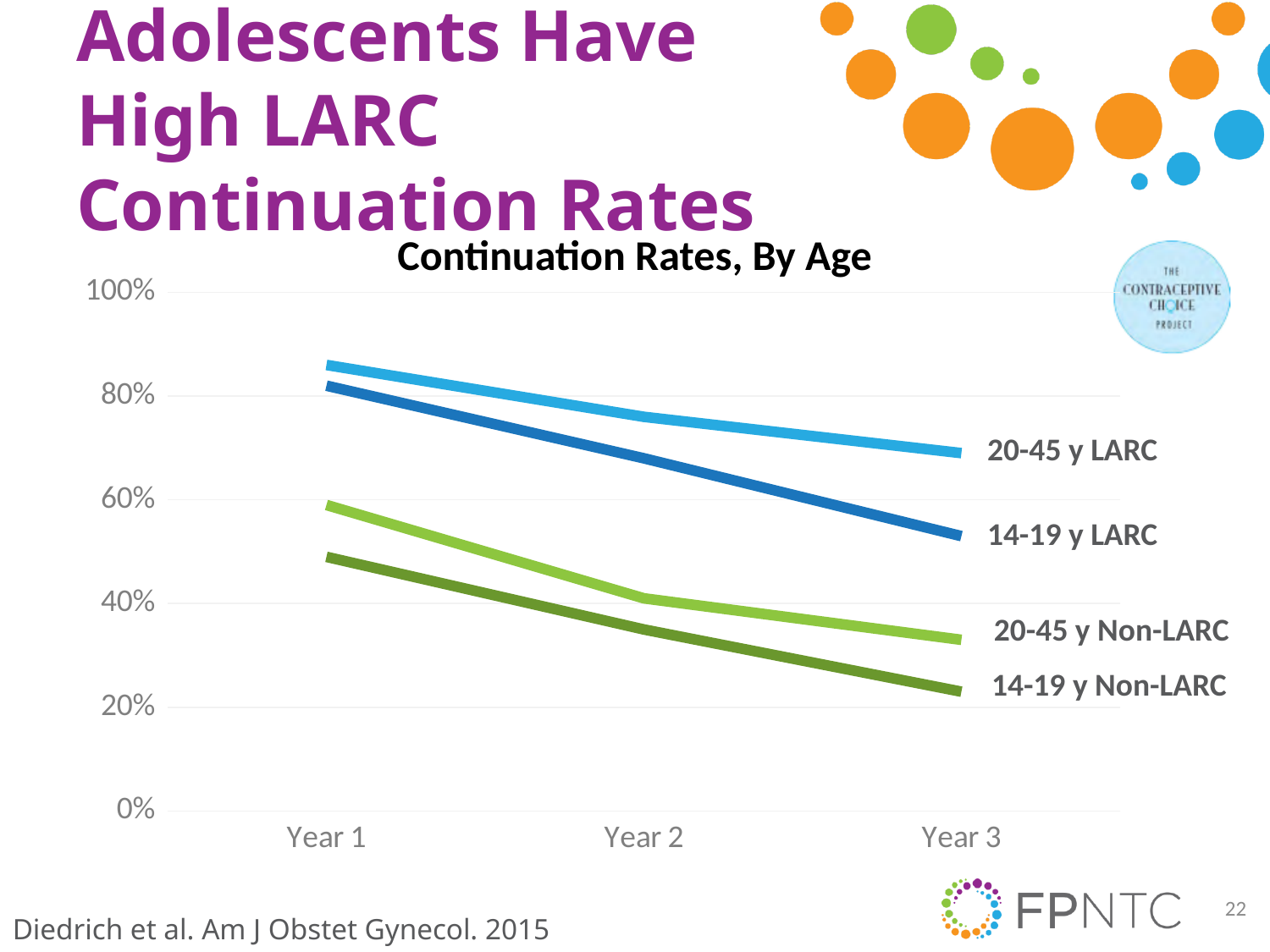
What is the title of the chart? Continuation Rates, By Age Is the continuation rate for 20-45 y LARC at Year 3 greater or less than 60%? greater How many time points are shown on the x axis? 3 Which series has the highest continuation rate at Year 3? 20-45 y LARC Which series has the lowest continuation rate at Year 3? 14-19 y Non-LARC How many series (lines) are plotted on the chart? 4 Is the continuation rate for 14-19 y LARC at Year 3 greater or less than 60%? less Is the continuation rate for 20-45 y LARC at Year 1 greater or less than 80%? greater At Year 2, which is higher: 14-19 y LARC or 20-45 y Non-LARC? 14-19 y LARC What kind of chart is shown on the slide? line chart Do the continuation rates for 14-19 y LARC rise or fall from Year 1 to Year 3? fall